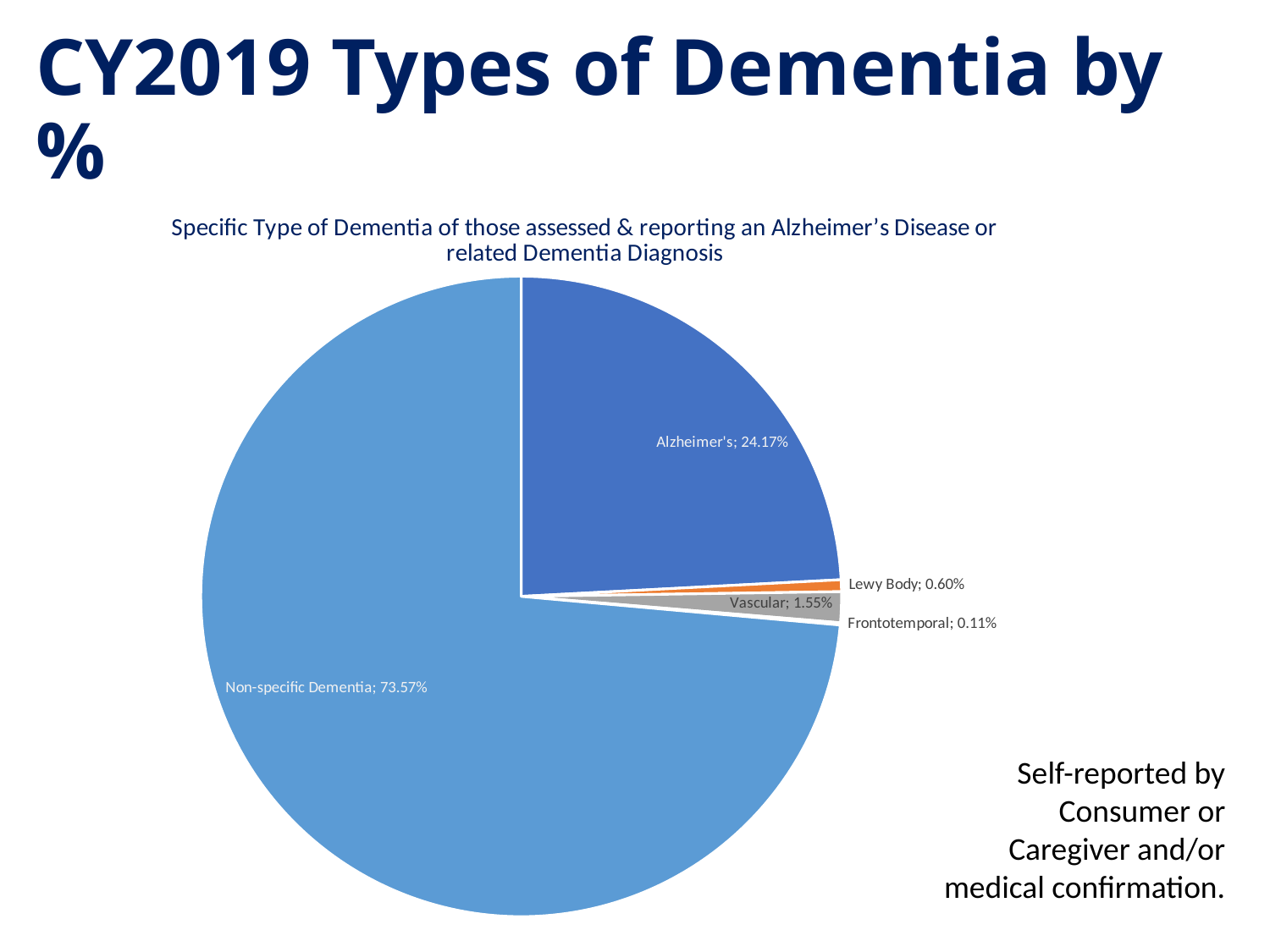
What is the difference in percentage points between Non-specific Dementia and Alzheimer's? 49.40 What percentage is shown for Non-specific Dementia? 73.57% What percentage is shown for Lewy Body? 0.60% Which type of dementia has the largest share of the pie? Non-specific Dementia Which type of dementia has the smallest share of the pie? Frontotemporal What percentage is shown for Frontotemporal? 0.11% What is the title of the pie chart? Specific Type of Dementia of those assessed & reporting an Alzheimer's Disease or related Dementia Diagnosis What type of chart is shown on the slide? pie chart Which is larger, the share for Vascular or the share for Lewy Body? Vascular What percentage is shown for Alzheimer's? 24.17% How many slices does the pie chart have? 5 What percentage is shown for Vascular? 1.55%